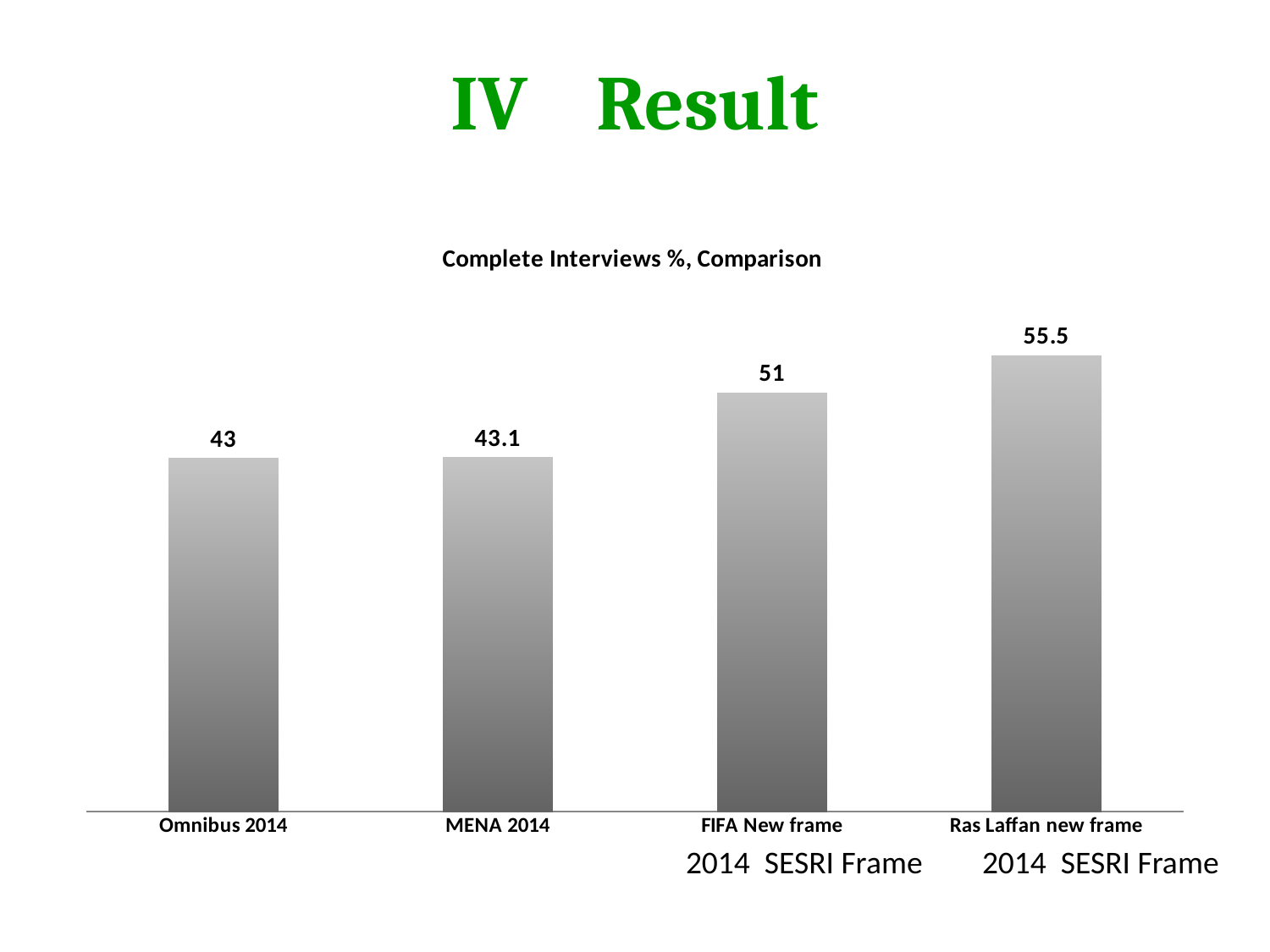
What kind of chart is shown on the slide? Bar chart Do the values rise or fall from left to right across the categories? Rise What is the title of the chart? Complete Interviews %, Comparison What is the difference between the values for Ras Laffan new frame and FIFA New frame? 4.5 What is the value for MENA 2014? 43.1 What is the value for FIFA New frame? 51 What is the value for Ras Laffan new frame? 55.5 Which category has the highest value? Ras Laffan new frame What is the value for Omnibus 2014? 43 Which is larger, the value for FIFA New frame or the value for Omnibus 2014? FIFA New frame What is the difference between the values for FIFA New frame and Omnibus 2014? 8 How many categories are shown in the chart? 4